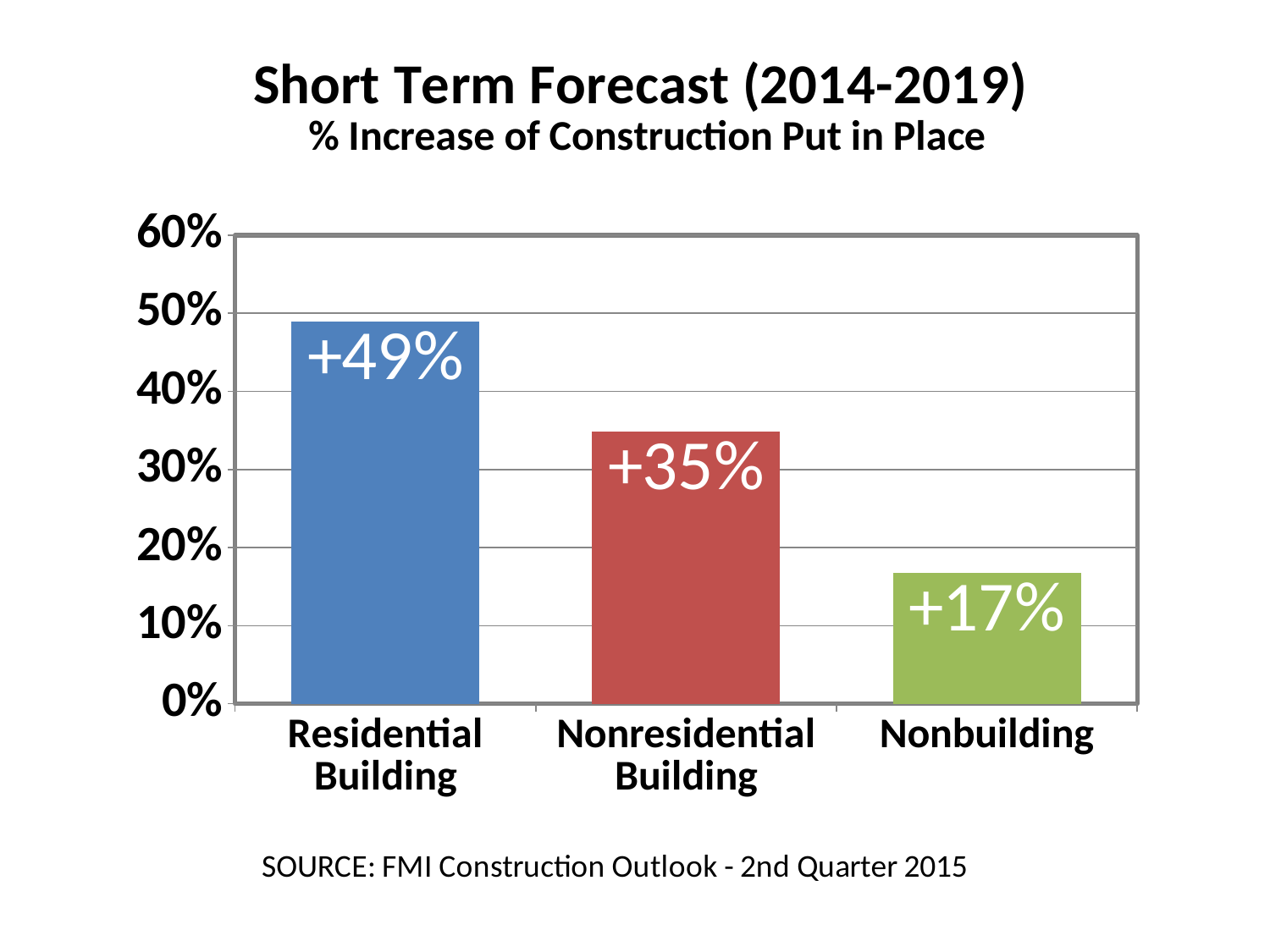
Which category has the highest value? Residential Building What is the difference between the values for Nonresidential Building and Nonbuilding? 18% What is the value for Nonresidential Building? +35% Is the value for Nonbuilding greater or less than 20%? less Which category has the lowest value? Nonbuilding What is the value for Nonbuilding? +17% What kind of chart is shown on the slide? bar chart What is the value for Residential Building? +49% How many categories are shown in the chart? 3 What is the title of the chart? Short Term Forecast (2014-2019) What is the difference between the values for Residential Building and Nonresidential Building? 14% Which is larger, the value for Nonresidential Building or the value for Nonbuilding? Nonresidential Building